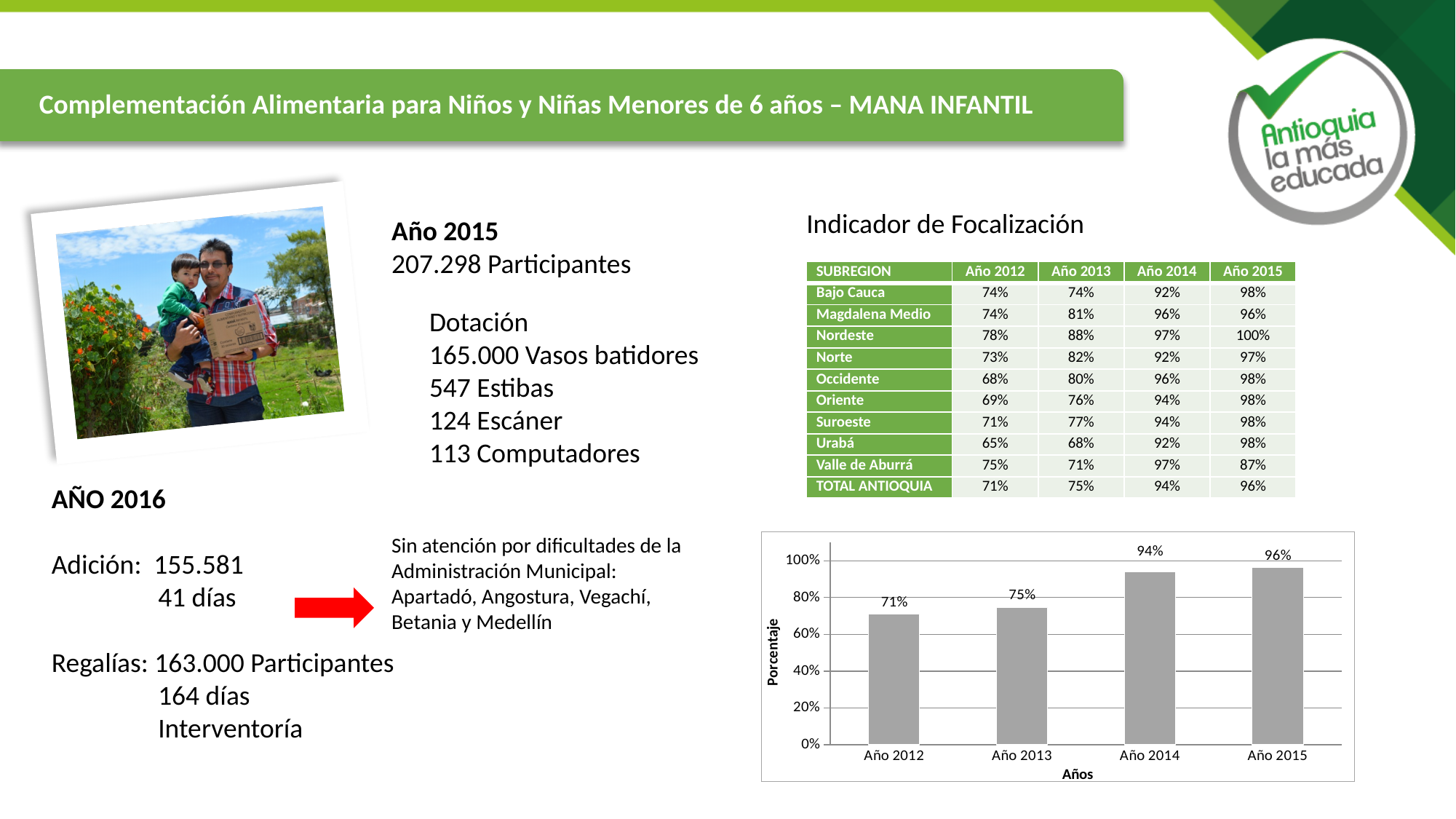
Which is larger in the bar chart, the value for Año 2013 or Año 2014? Año 2014 Do the values in the bar chart rise or fall from Año 2012 to Año 2015? rise What is the value for Año 2012 in the bar chart? 71% What kind of chart is shown on the slide? bar chart What is the value for Año 2015 in the bar chart? 96% What is the label of the y axis of the bar chart? Porcentaje How many years are shown on the x axis of the bar chart? 4 What is the difference between the values for Año 2014 and Año 2013 in the bar chart? 19% Which year has the lowest value in the bar chart? Año 2012 Is the value for Año 2013 in the bar chart greater or less than 80%? less What is the value for Año 2014 in the bar chart? 94% Which year has the highest value in the bar chart? Año 2015